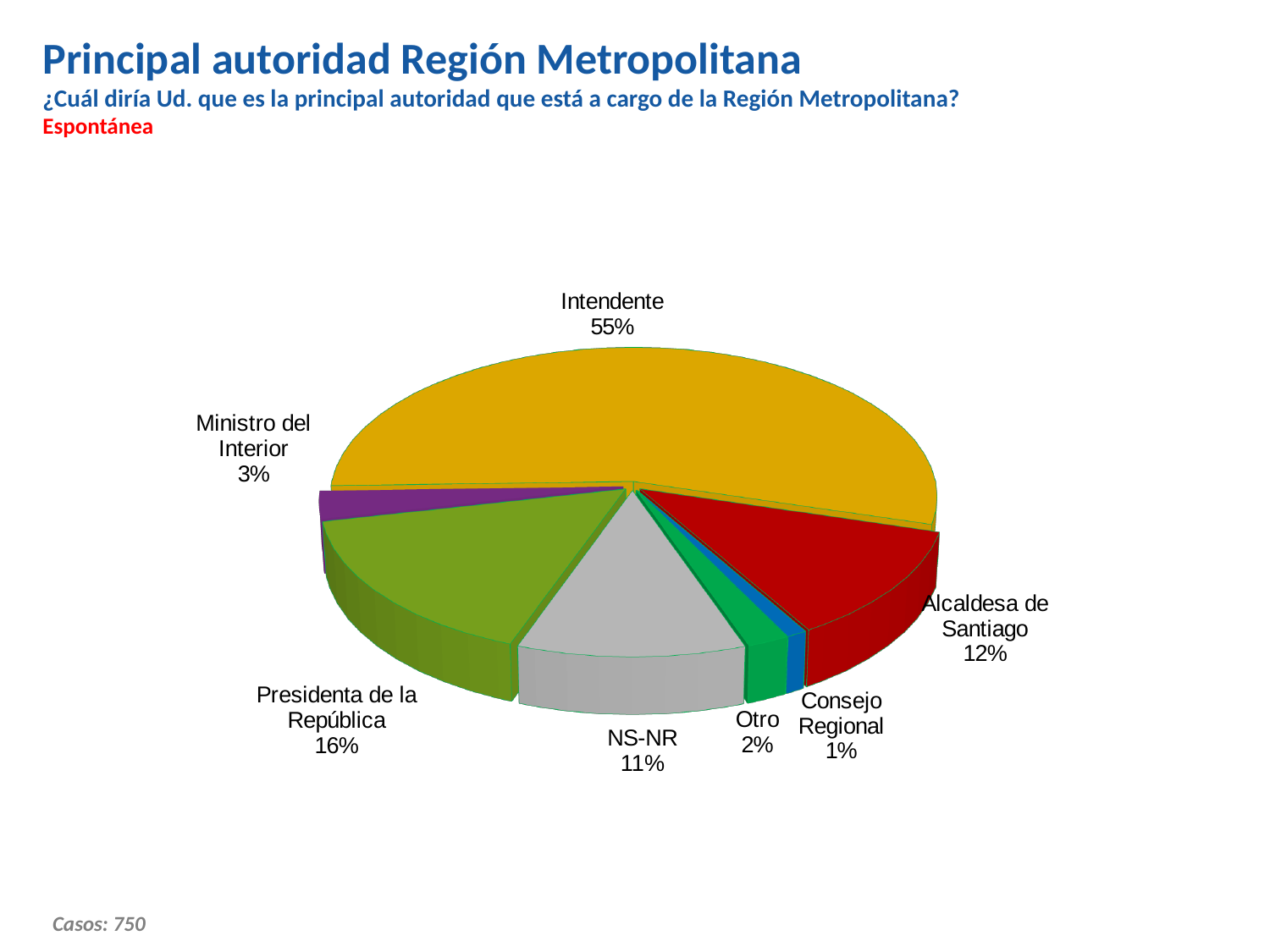
What is the difference in percentage points between Intendente and Presidenta de la República? 39 What percentage is shown for Alcaldesa de Santiago? 12% What type of chart is shown on the slide? Pie chart What is the value for NS-NR? 11% What percentage of respondents named Intendente as the principal authority? 55% Which category has the largest slice of the pie? Intendente What percentage is shown for Ministro del Interior? 3% How many categories are shown in the pie chart? 7 Which is larger, the value for Alcaldesa de Santiago or the value for NS-NR? Alcaldesa de Santiago What colour is the Intendente slice? Yellow Which category has the smallest slice of the pie? Consejo Regional What is the value shown for Presidenta de la República? 16%